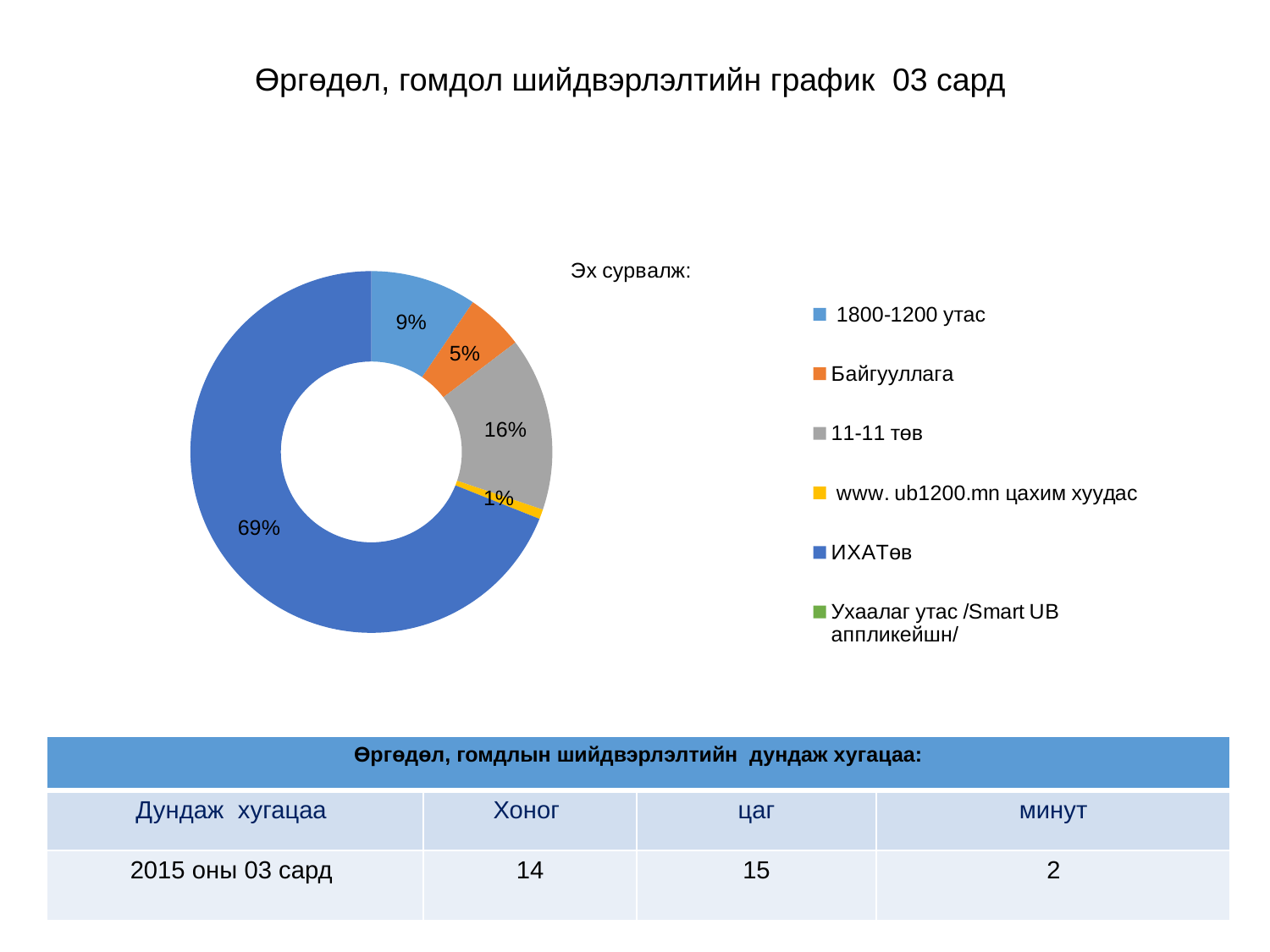
What share of the doughnut chart does ИХАТөв account for? 69% How many entries does the legend of the doughnut chart list? 6 Which is larger in the doughnut chart: the share for 11-11 төв or the share for 1800-1200 утас? 11-11 төв What is the difference between the share for ИХАТөв and the share for 11-11 төв? 53% What is the difference between the share for 1800-1200 утас and the share for Байгууллага? 4% What share of the doughnut chart does 11-11 төв account for? 16% What share of the doughnut chart does www. ub1200.mn цахим хуудас account for? 1% What is the title shown above the legend of the doughnut chart? Эх сурвалж: What kind of chart is shown on the slide? Doughnut (pie) chart Which source has the largest share in the doughnut chart? ИХАТөв